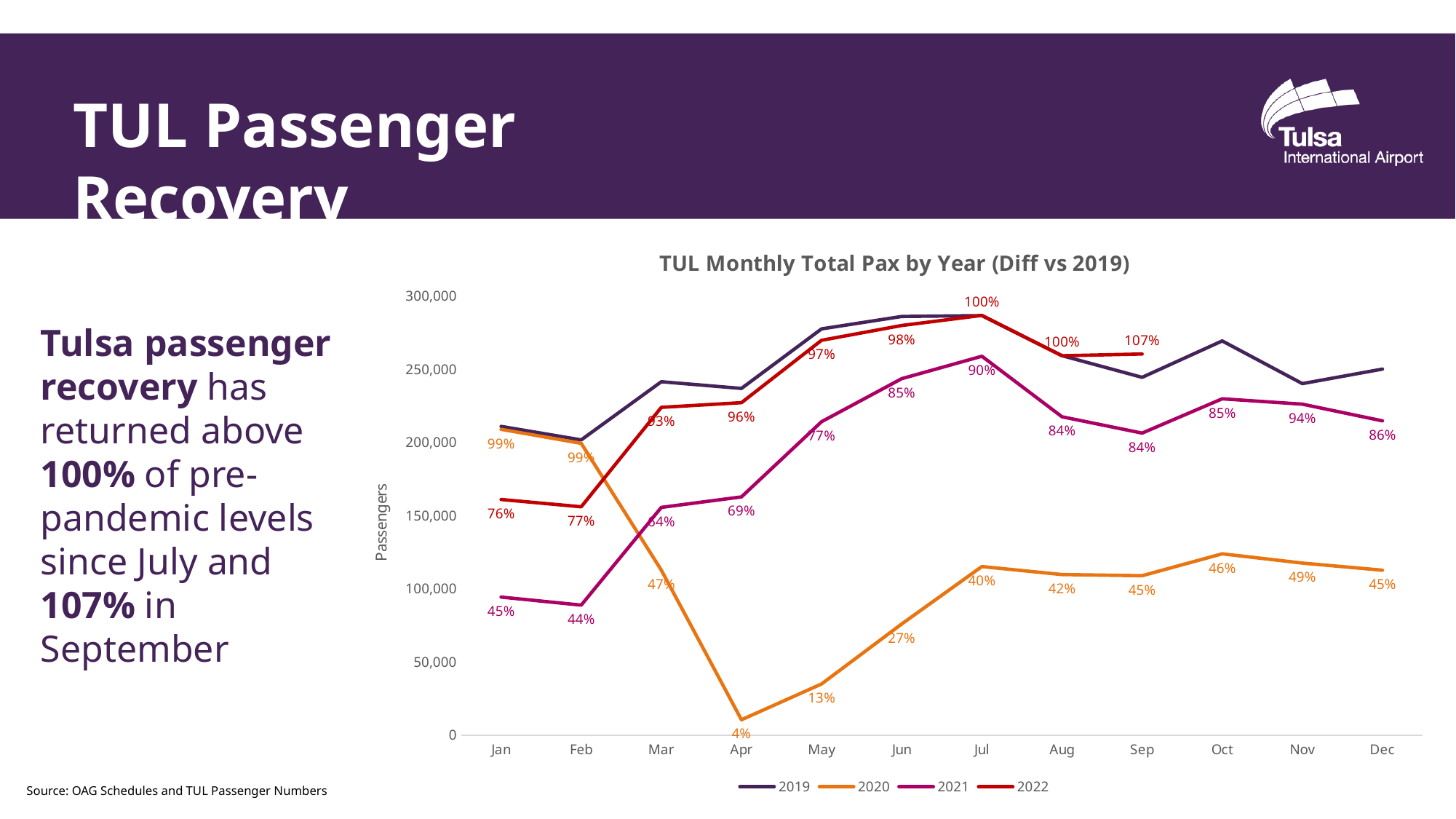
What percentage label is shown for the 2022 series in September? 107% In which month does the 2021 series have its highest percentage label? Nov How many months are shown along the x axis? 12 What kind of chart is shown on the slide? Line chart What percentage label is shown for the 2021 series in November? 94% What percentage label is shown for the 2020 series in April? 4% In which month does the 2020 series have its lowest percentage label? Apr How many series does the legend list? 4 What is the title of the chart? TUL Monthly Total Pax by Year (Diff vs 2019) Is the 2019 passenger value for July greater or less than 250,000? greater Is the 2020 passenger value for December greater or less than 150,000? less Which series has the higher passenger value in April, 2021 or 2022? 2022